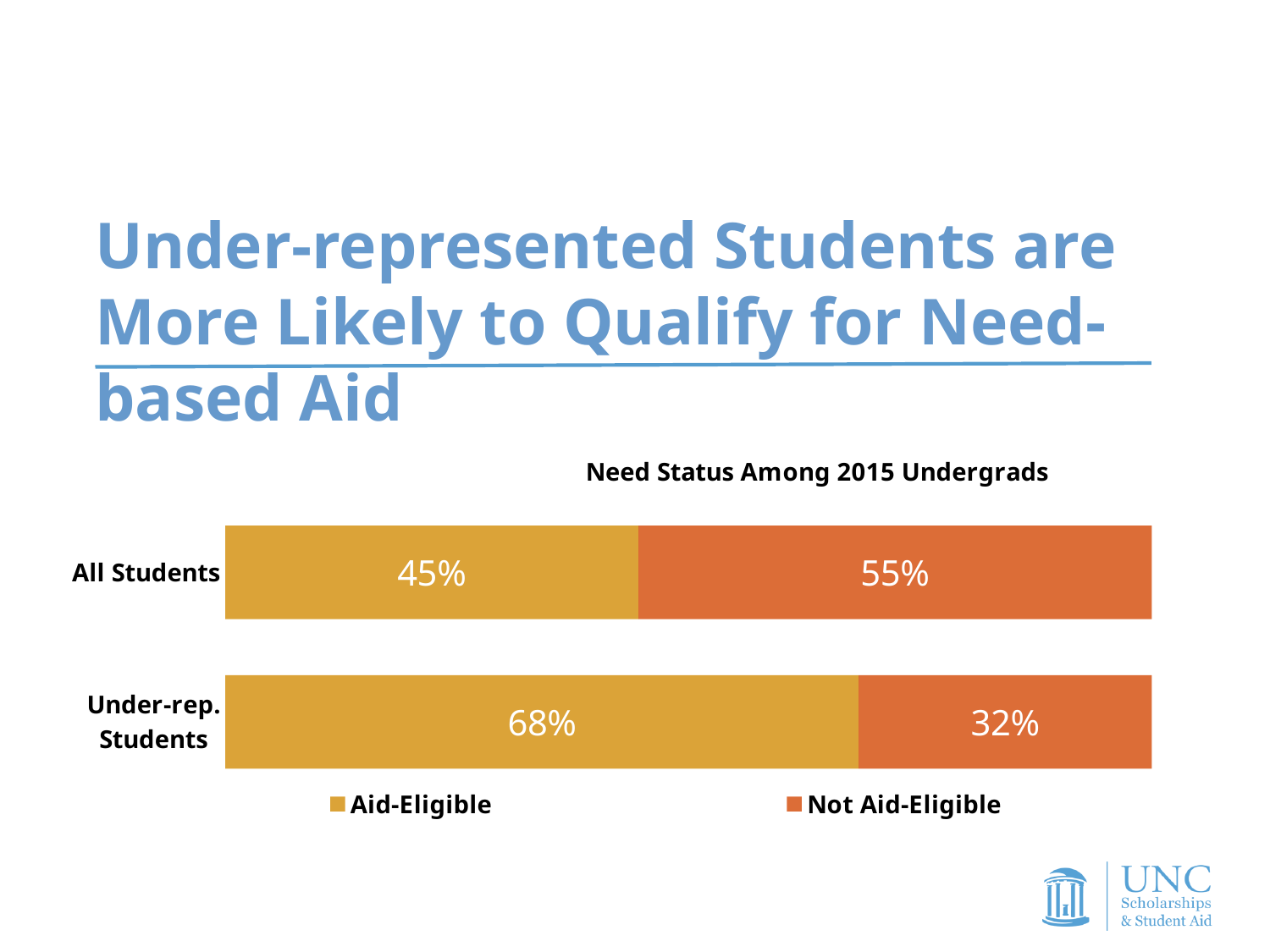
What kind of chart is shown on the slide? Stacked bar chart What percentage of All Students are Aid-Eligible? 45% How many percentage points higher is the Aid-Eligible share for Under-rep. Students than for All Students? 23 What is the title of the chart? Need Status Among 2015 Undergrads What percentage of Under-rep. Students are Aid-Eligible? 68% Which category has the lower Not Aid-Eligible share? Under-rep. Students What percentage of All Students are Not Aid-Eligible? 55% Which category has the higher Aid-Eligible share? Under-rep. Students What percentage of Under-rep. Students are Not Aid-Eligible? 32% How many series does the legend list? 2 Is the Not Aid-Eligible share larger for All Students or for Under-rep. Students? All Students How many categories are shown in the chart? 2